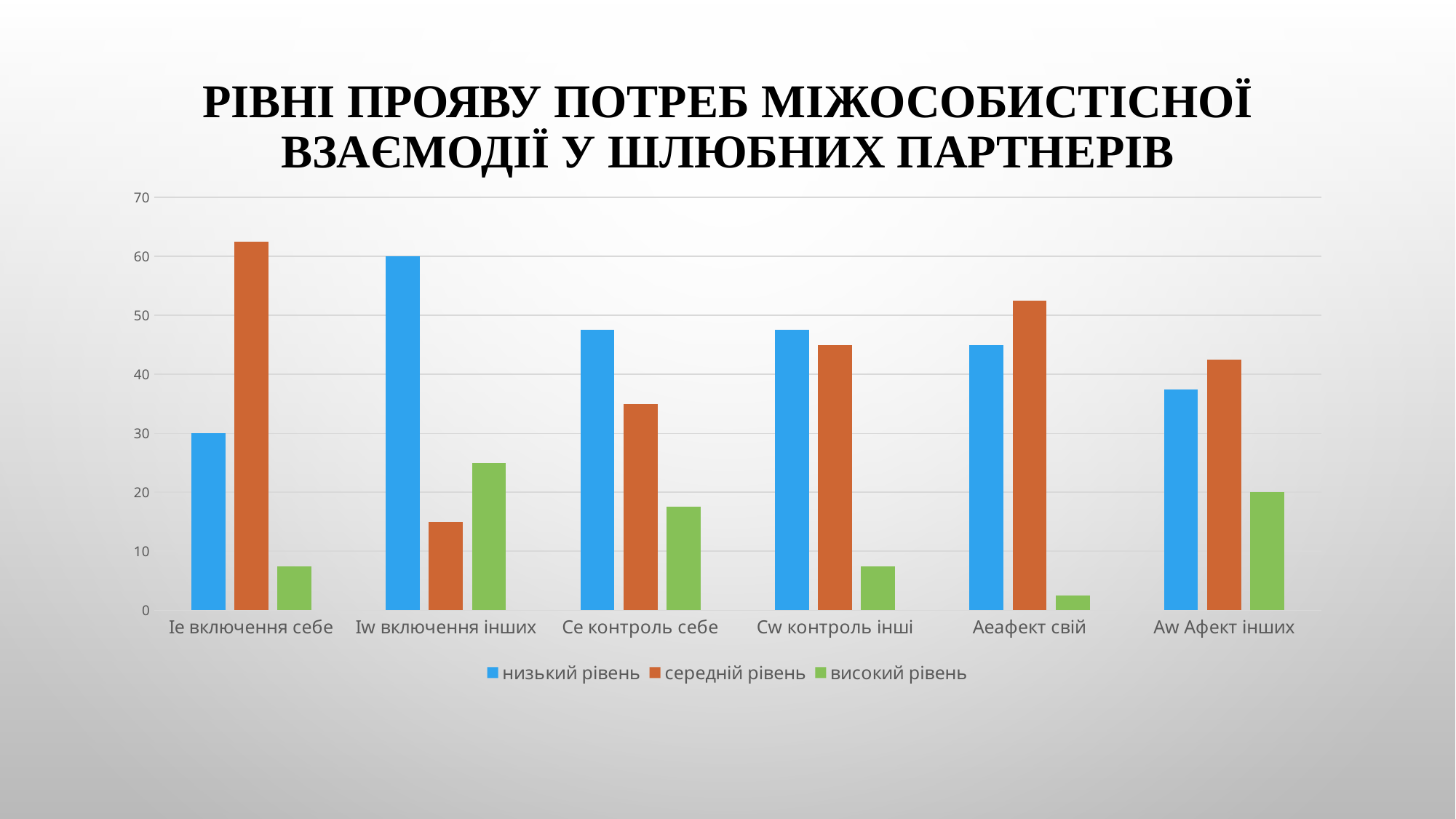
Which colour represents 'високий рівень' in the legend? green Is the value of 'високий рівень' for 'Aeафект свій' greater or less than 10? less Is the value of 'середній рівень' for 'Ie включення себе' greater or less than 60? greater What is the value of 'низький рівень' for 'Iw включення інших'? 60 Which category has the highest 'середній рівень' value? Ie включення себе What is the value of 'високий рівень' for 'Aw Афект інших'? 20 How many categories are shown along the x axis? 6 What is the value of 'низький рівень' for 'Ie включення себе'? 30 What type of chart is shown on the slide? bar chart Is the value of 'середній рівень' for 'Aeафект свій' greater or less than 50? greater Which category has the lowest 'високий рівень' value? Aeафект свій How many series does the legend list? 3